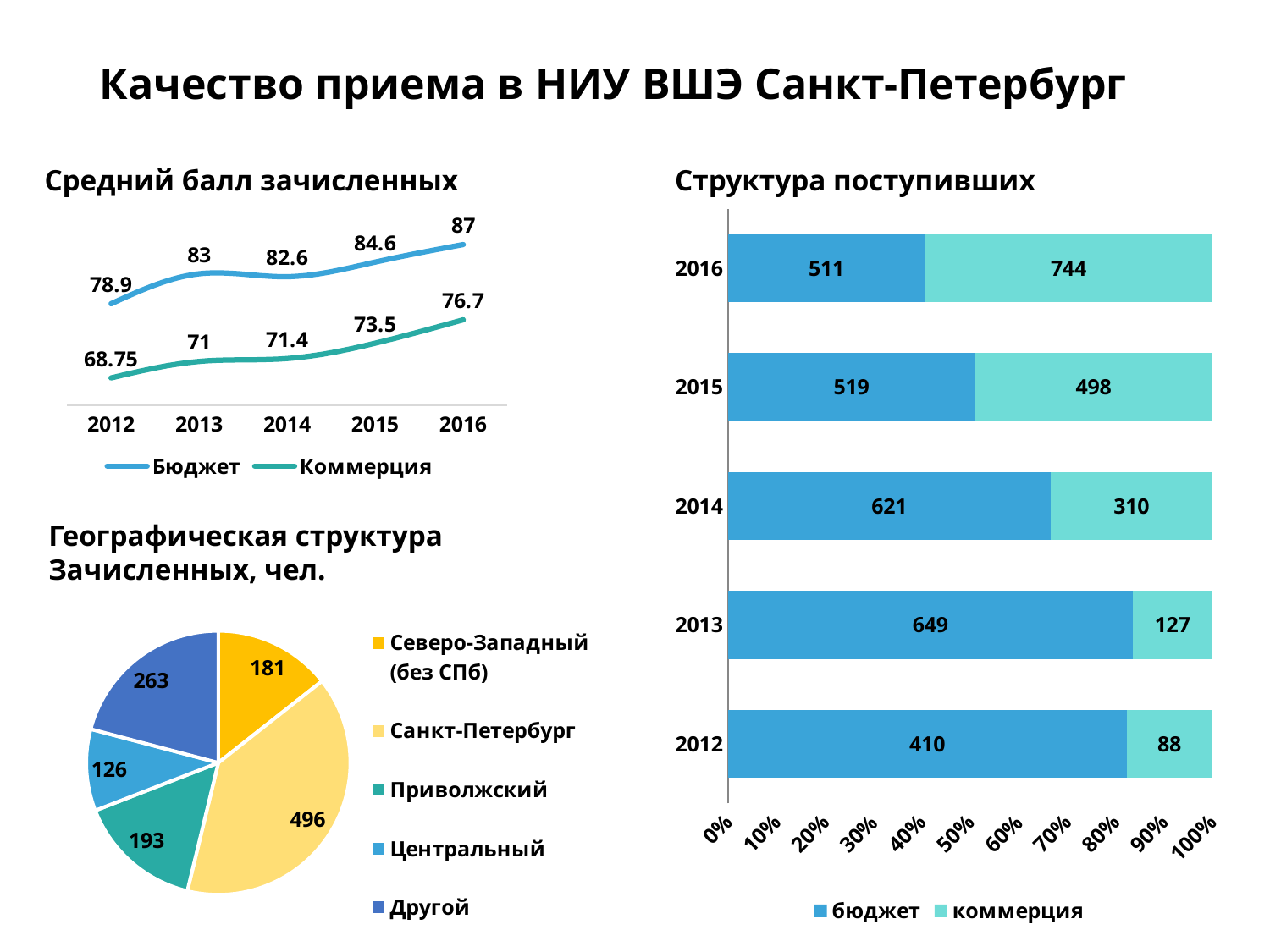
What kind of chart is 'Географическая структура Зачисленных, чел.'? pie chart In the chart 'Структура поступивших', what is the value for коммерция in 2014? 310 In the pie chart 'Географическая структура Зачисленных, чел.', which is larger: Северо-Западный (без СПб) or Другой? Другой In the chart 'Структура поступивших', how many years are shown? 5 In the chart 'Средний балл зачисленных', what is the difference between Бюджет and Коммерция in 2015? 11.1 In the chart 'Средний балл зачисленных', how many series does the legend list? 2 In the chart 'Средний балл зачисленных', what is the value for Коммерция in 2012? 68.75 In the chart 'Средний балл зачисленных', does the Коммерция line rise or fall from 2012 to 2016? rise In the pie chart 'Географическая структура Зачисленных, чел.', what is the value for Приволжский? 193 In the chart 'Структура поступивших', what is the total of the 2016 bar? 1255 In the pie chart 'Географическая структура Зачисленных, чел.', which category has the largest value? Санкт-Петербург In the chart 'Средний балл зачисленных', what is the value for Бюджет in 2016? 87